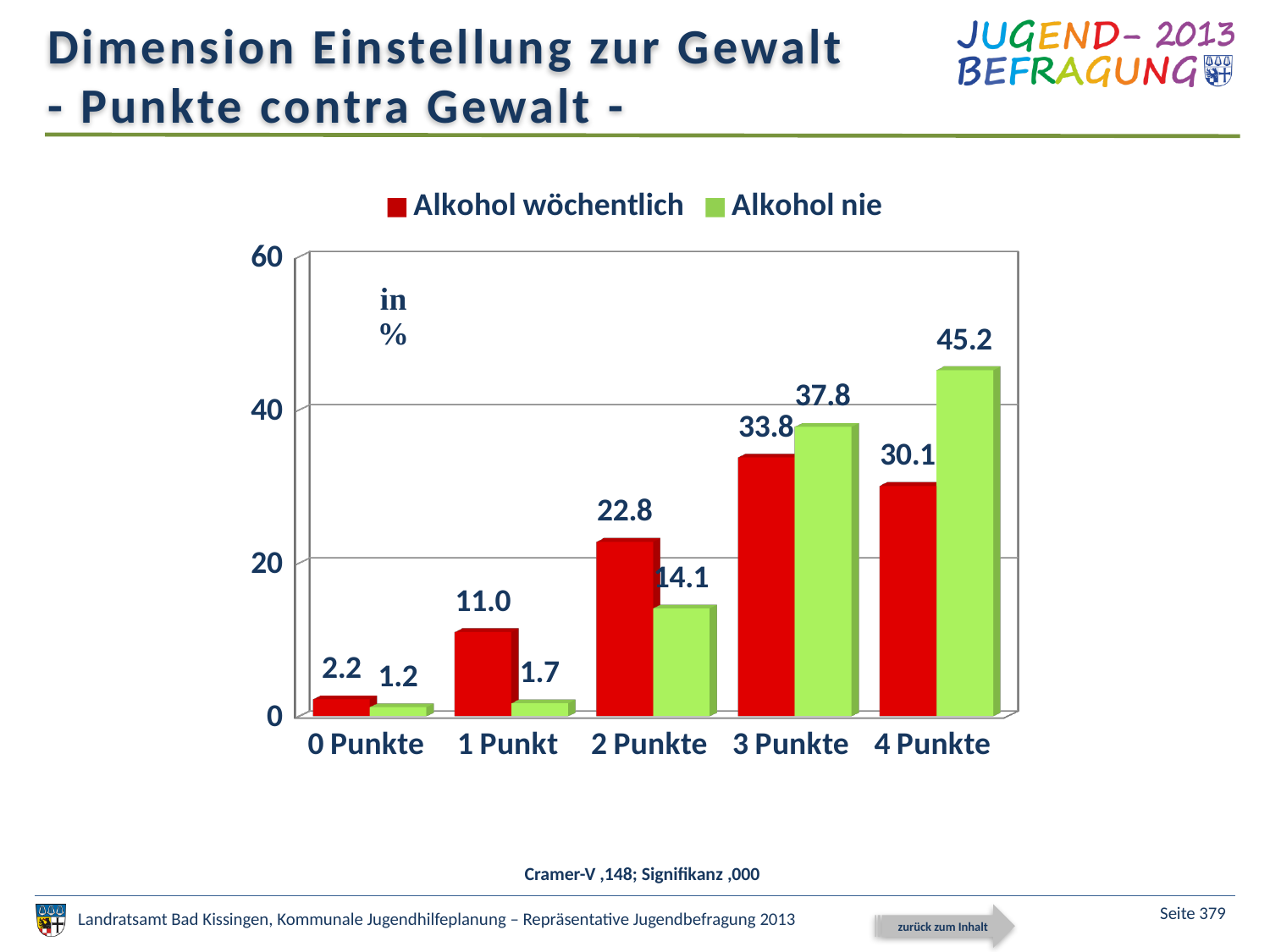
Which colour represents 'Alkohol nie' in the chart? green At 2 Punkte, which series has the larger value, 'Alkohol wöchentlich' or 'Alkohol nie'? Alkohol wöchentlich What is the value for 'Alkohol wöchentlich' at 2 Punkte? 22.8 Which category has the highest value for 'Alkohol wöchentlich'? 3 Punkte How many series does the legend list? 2 Is the value for 'Alkohol nie' at 3 Punkte greater or less than 40? less How many categories are shown on the x axis? 5 What is the difference between 'Alkohol nie' and 'Alkohol wöchentlich' at 4 Punkte? 15.1 Which category has the lowest value for 'Alkohol nie'? 0 Punkte What kind of chart is shown on the slide? bar chart What is the value for 'Alkohol nie' at 4 Punkte? 45.2 What is the value for 'Alkohol wöchentlich' at 1 Punkt? 11.0